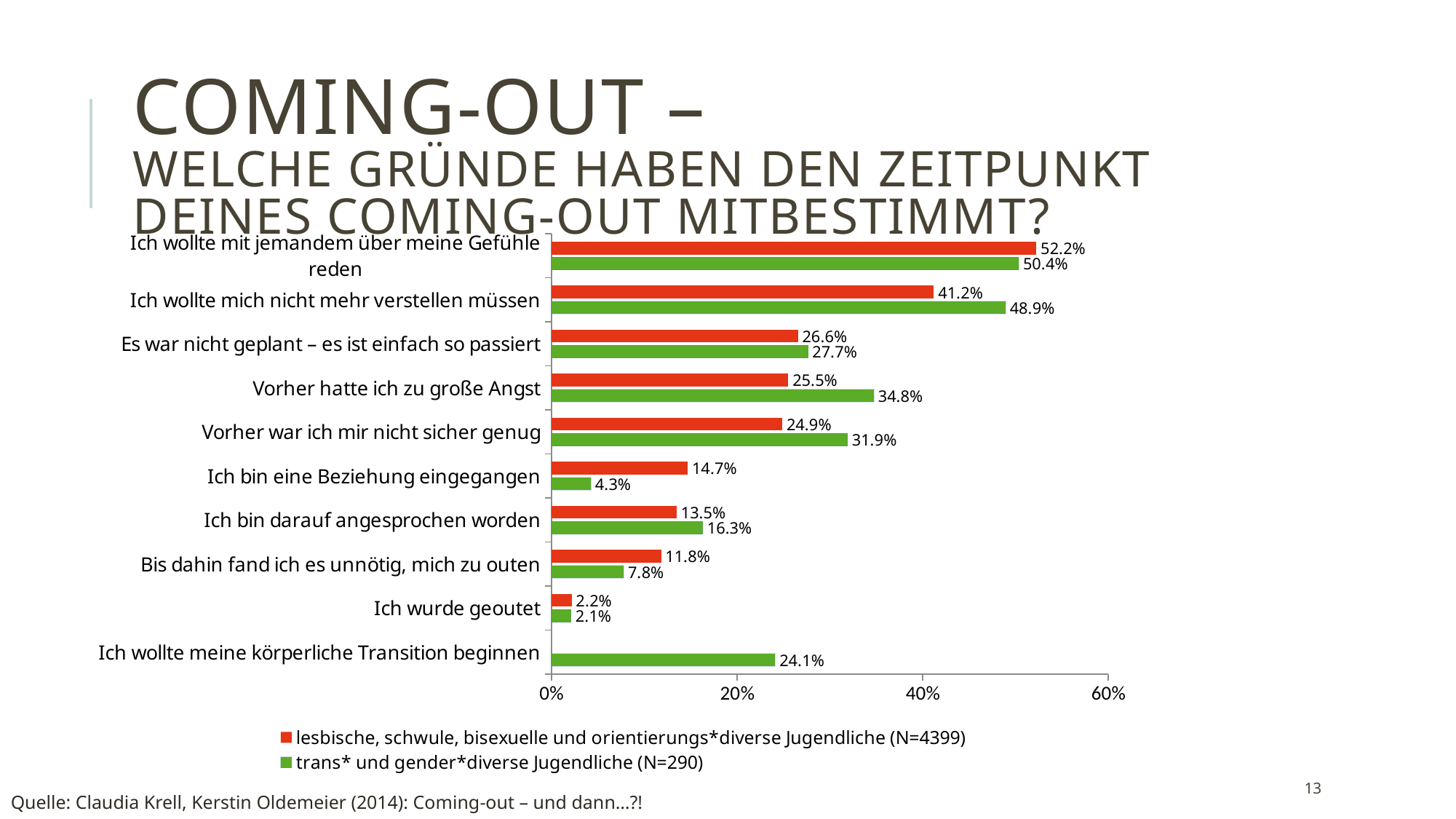
Which category has the lowest value for trans* und gender*diverse Jugendliche? Ich wurde geoutet What is the value for 'Ich wollte mit jemandem über meine Gefühle reden' for lesbische, schwule, bisexuelle und orientierungs*diverse Jugendliche? 52.2% What kind of chart is shown on the slide? bar chart Which category has the highest value for lesbische, schwule, bisexuelle und orientierungs*diverse Jugendliche? Ich wollte mit jemandem über meine Gefühle reden How many series does the legend list? 2 What is the difference between the two series for 'Vorher hatte ich zu große Angst'? 9.3 percentage points How many categories (reasons) are shown on the chart? 10 What is the value for 'Ich wollte meine körperliche Transition beginnen' for trans* und gender*diverse Jugendliche? 24.1% For 'Ich bin eine Beziehung eingegangen', which series has the larger value? lesbische, schwule, bisexuelle und orientierungs*diverse Jugendliche (N=4399) Which colour represents trans* und gender*diverse Jugendliche in the chart? green Is the value for 'Vorher war ich mir nicht sicher genug' for trans* und gender*diverse Jugendliche greater or less than 20%? greater What is the value for 'Ich wollte mich nicht mehr verstellen müssen' for trans* und gender*diverse Jugendliche? 48.9%